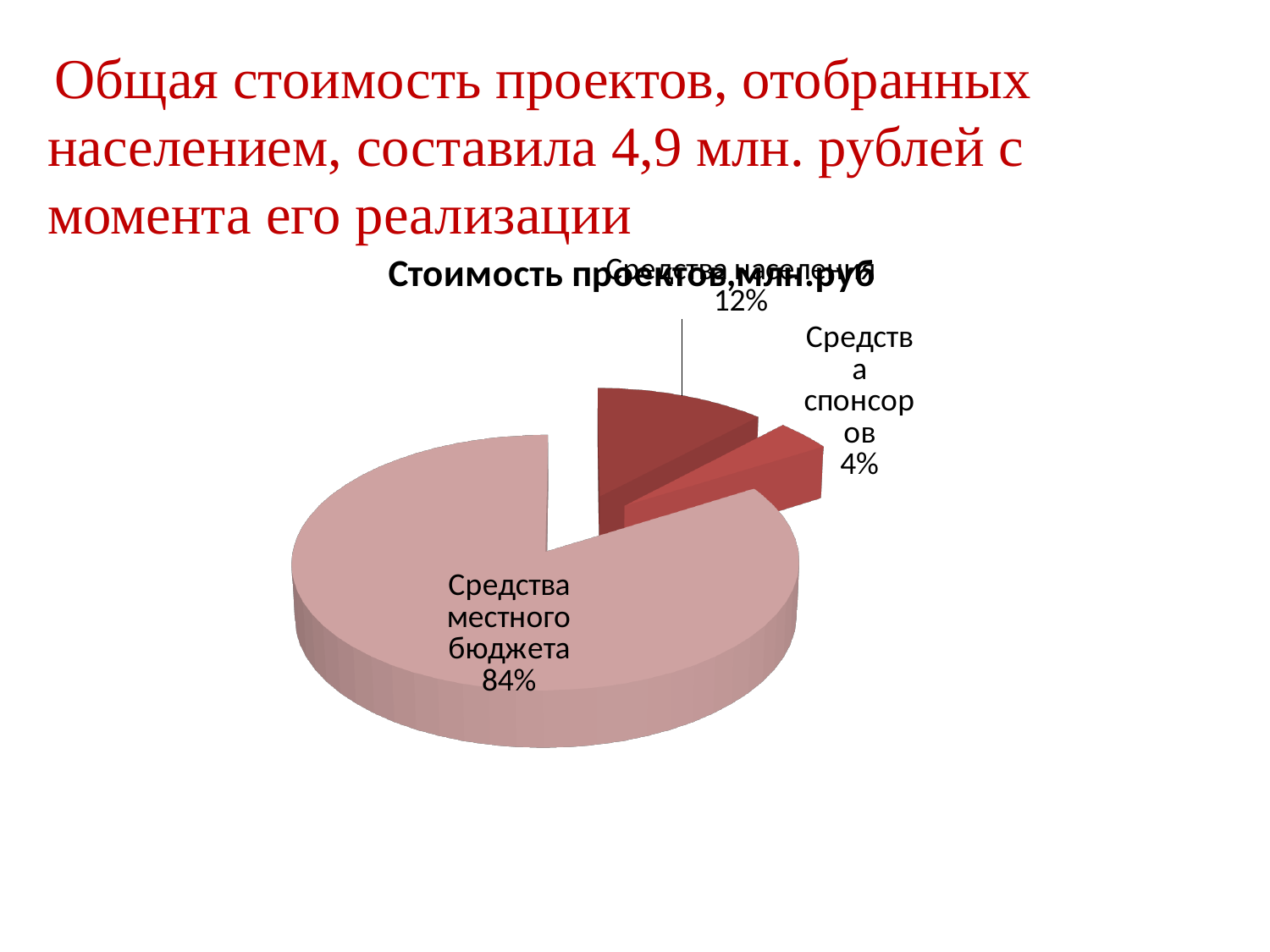
What share of the pie is Средства спонсоров? 4% What is the title of the pie chart? Стоимость проектов,млн.руб Which slice of the pie chart is the largest? Средства местного бюджета How many slices does the pie chart have? 3 What share of the pie is Средства местного бюджета? 84% What kind of chart is shown on the slide? pie chart Which is larger: the share for Средства населения or the share for Средства спонсоров? Средства населения By how many percentage points does Средства местного бюджета exceed Средства спонсоров? 80 percentage points What share of the pie is Средства населения? 12% Which slice of the pie chart is the smallest? Средства спонсоров By how many percentage points does Средства населения exceed Средства спонсоров? 8 percentage points